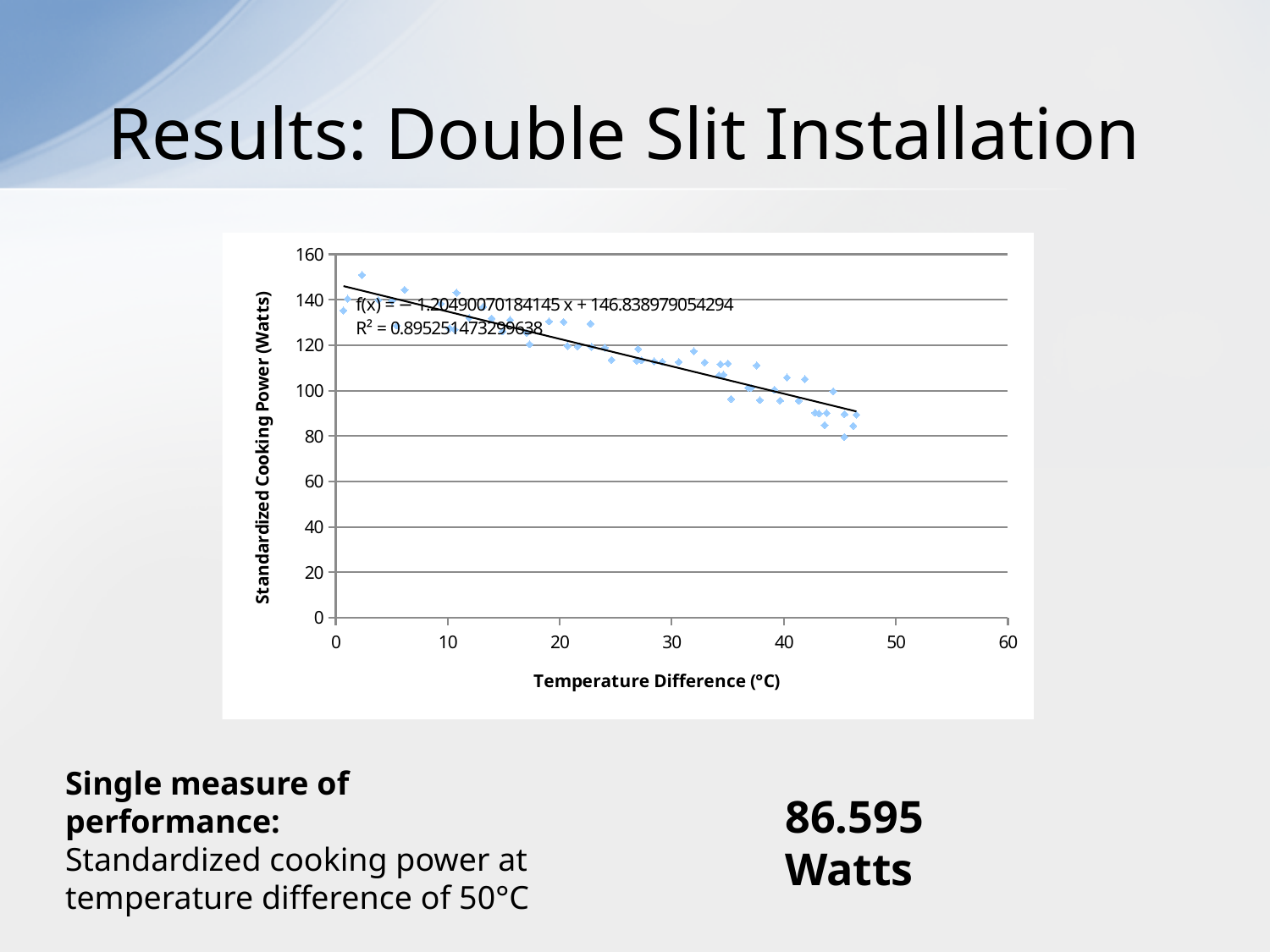
What is the title of the y axis of the chart? Standardized Cooking Power (Watts) Do the plotted values of standardized cooking power rise or fall as temperature difference increases along the x axis? fall What is the slope of the fitted line equation printed on the chart? -1.20490070184145 What is the intercept of the fitted line equation printed on the chart? 146.838979054294 What is the highest tick value shown on the y axis? 160 What is the highest tick value shown on the x axis? 60 Is the standardized cooking power of the highest plotted point, near a temperature difference of 2°C, greater or less than 140? greater Are the plotted points at a temperature difference of about 40°C greater or less than 120 watts? less What kind of chart is shown on the slide? scatter chart What R² value is printed on the chart for the fitted line? 0.895251473299638 What is the title of the x axis of the chart? Temperature Difference (°C) Is the standardized cooking power of the lowest plotted point, near a temperature difference of 45°C, greater or less than 100? less